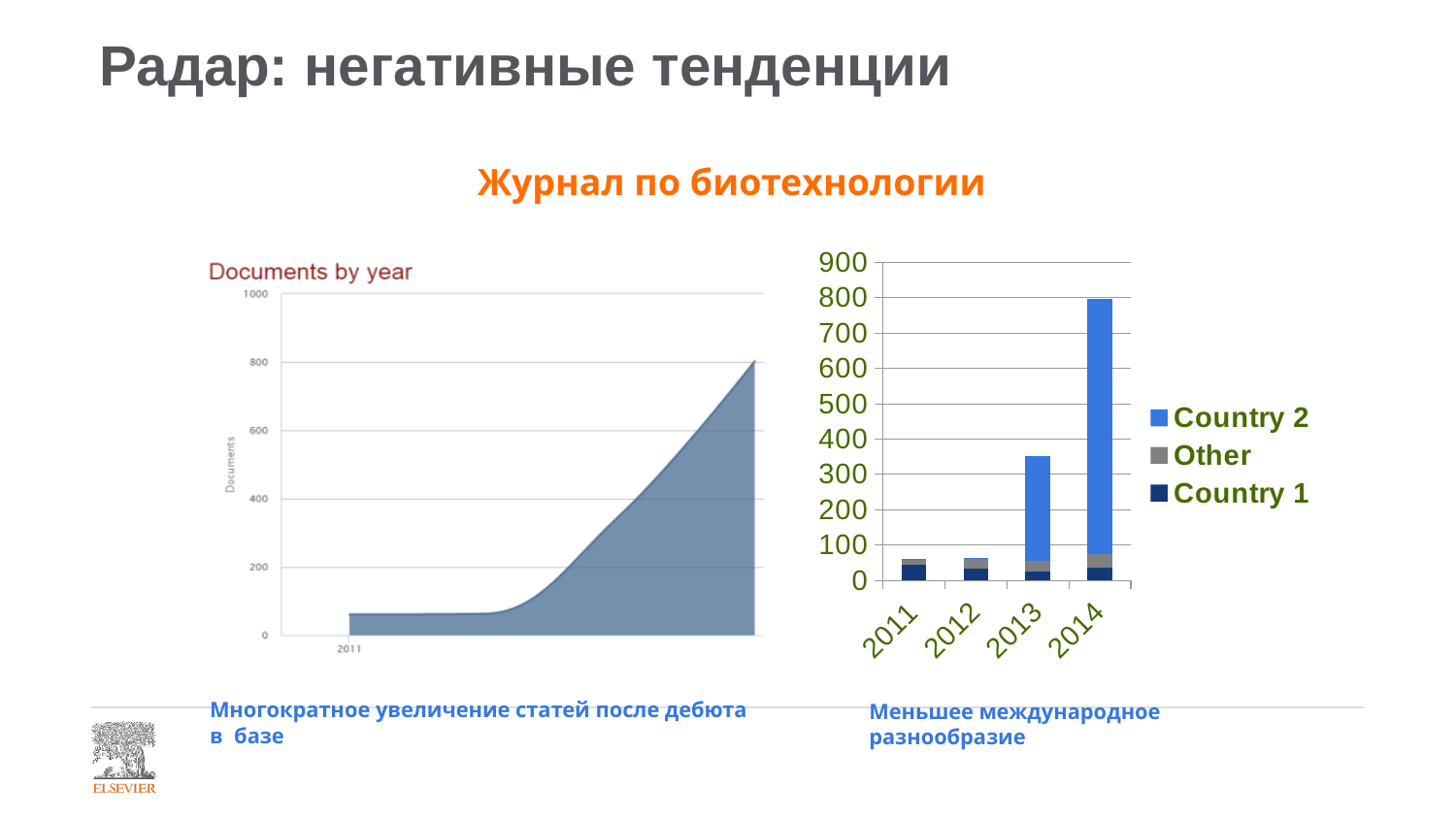
In the left-hand 'Documents by year' chart, do the values rise or fall from left to right? rise In the right-hand bar chart, which total is larger, 2013 or 2014? 2014 What is the title of the left-hand chart? Documents by year In the left-hand 'Documents by year' chart, is the value at the right end of the series greater or less than 600? greater In the right-hand bar chart, which series is shown in light blue according to the legend? Country 2 In the right-hand bar chart, is the total for 2014 greater or less than 700? greater How many series does the legend of the right-hand bar chart list? 3 In the right-hand bar chart, is the total for 2011 greater or less than 100? less What kind of chart is the right-hand chart with the years 2011 to 2014? bar chart How many years are shown on the x axis of the right-hand bar chart? 4 In the right-hand bar chart, which year has the highest total bar? 2014